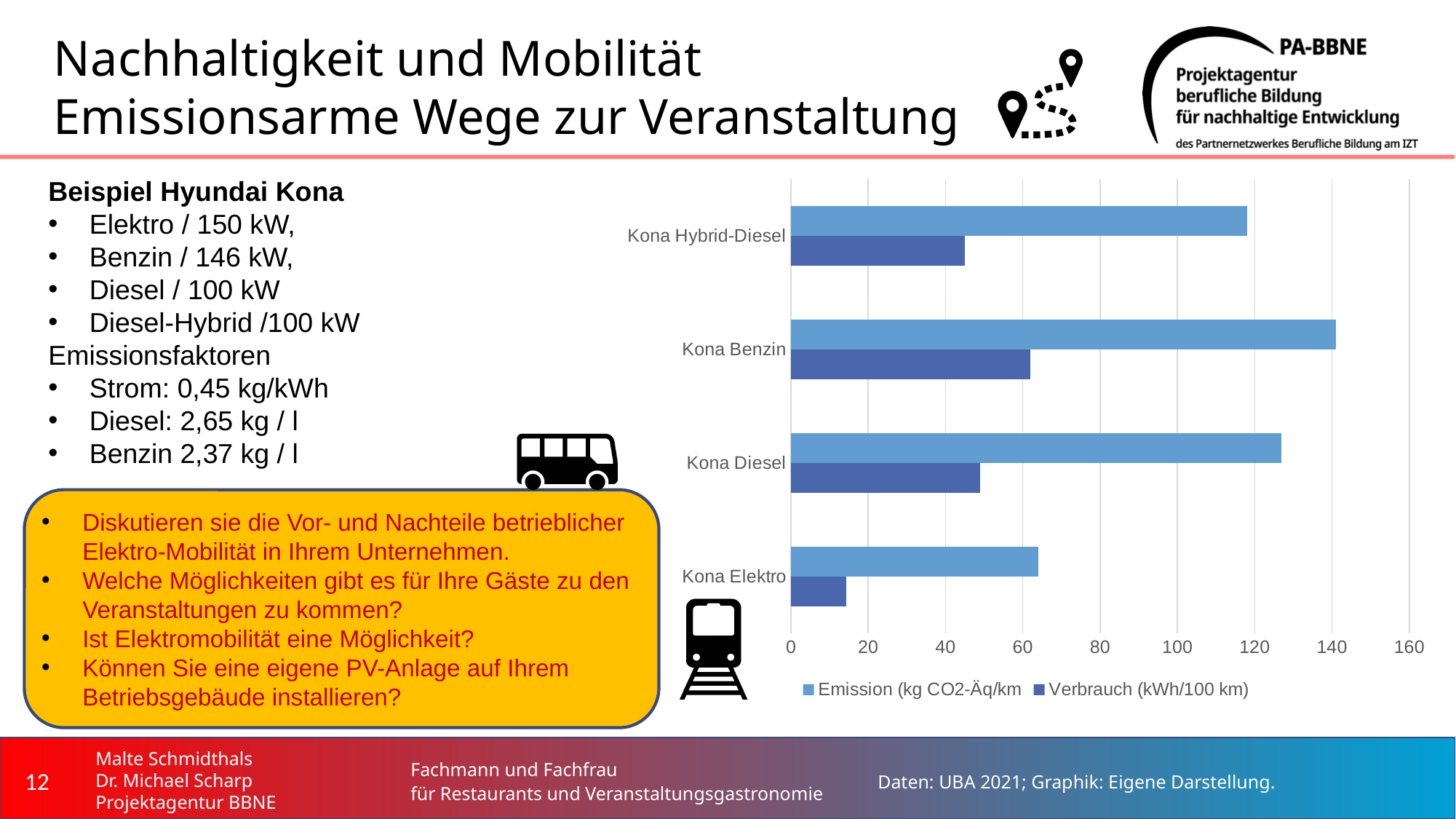
How many series does the chart legend list? 2 What kind of chart is shown on the slide? bar chart Is the Emission value for Kona Elektro greater or less than 80? less Which vehicle has the lowest Verbrauch (kWh/100 km) value? Kona Elektro How many vehicle categories are shown on the chart? 4 Which vehicle has the highest Verbrauch (kWh/100 km) value? Kona Benzin Is the Verbrauch value for Kona Elektro greater or less than 20? less Which is larger: the Emission value for Kona Diesel or for Kona Hybrid-Diesel? Kona Diesel Which vehicle has the lowest Emission (kg CO2-Äq/km) value? Kona Elektro Which vehicle has the highest Emission (kg CO2-Äq/km) value? Kona Benzin What are the two series named in the chart legend? Emission (kg CO2-Äq/km) and Verbrauch (kWh/100 km)